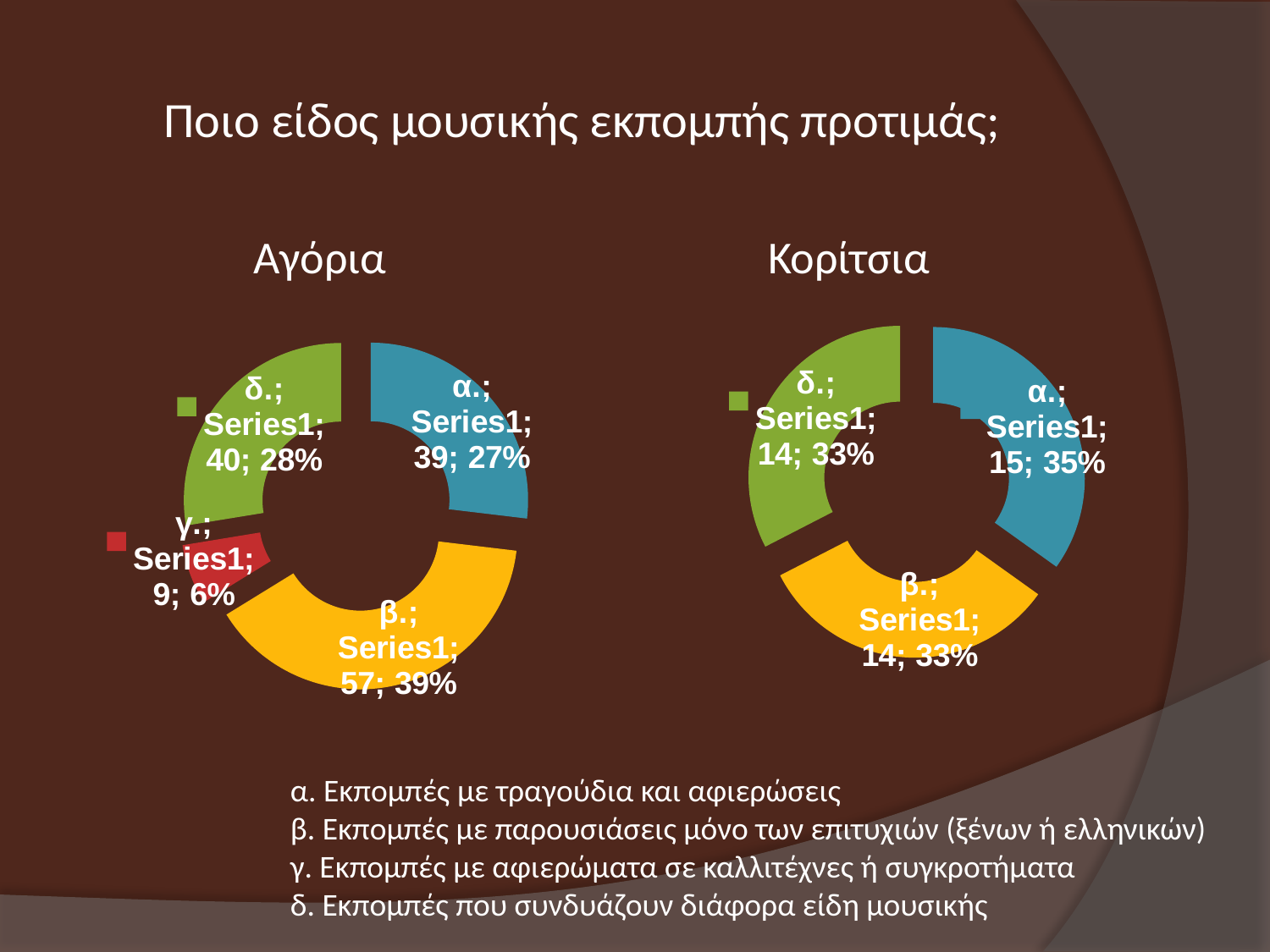
In the Αγόρια chart, what percentage share does category γ. have? 6% In the Κορίτσια chart, what value is shown for category α.? 15 What kind of chart is used for Αγόρια and Κορίτσια? doughnut chart How many categories are shown in the Κορίτσια chart? 3 In the Αγόρια chart, which is larger, the value for δ. or the value for α.? δ. In the Αγόρια chart, which category has the highest value? β. In the Κορίτσια chart, what percentage share does category α. have? 35% In the Αγόρια chart, which category has the lowest value? γ. In the Αγόρια chart, what is the difference between the values for β. and α.? 18 In the Αγόρια chart, what colour is the slice for category γ.? red How many categories are shown in the Αγόρια chart? 4 In the Αγόρια chart, what value is shown for category β.? 57